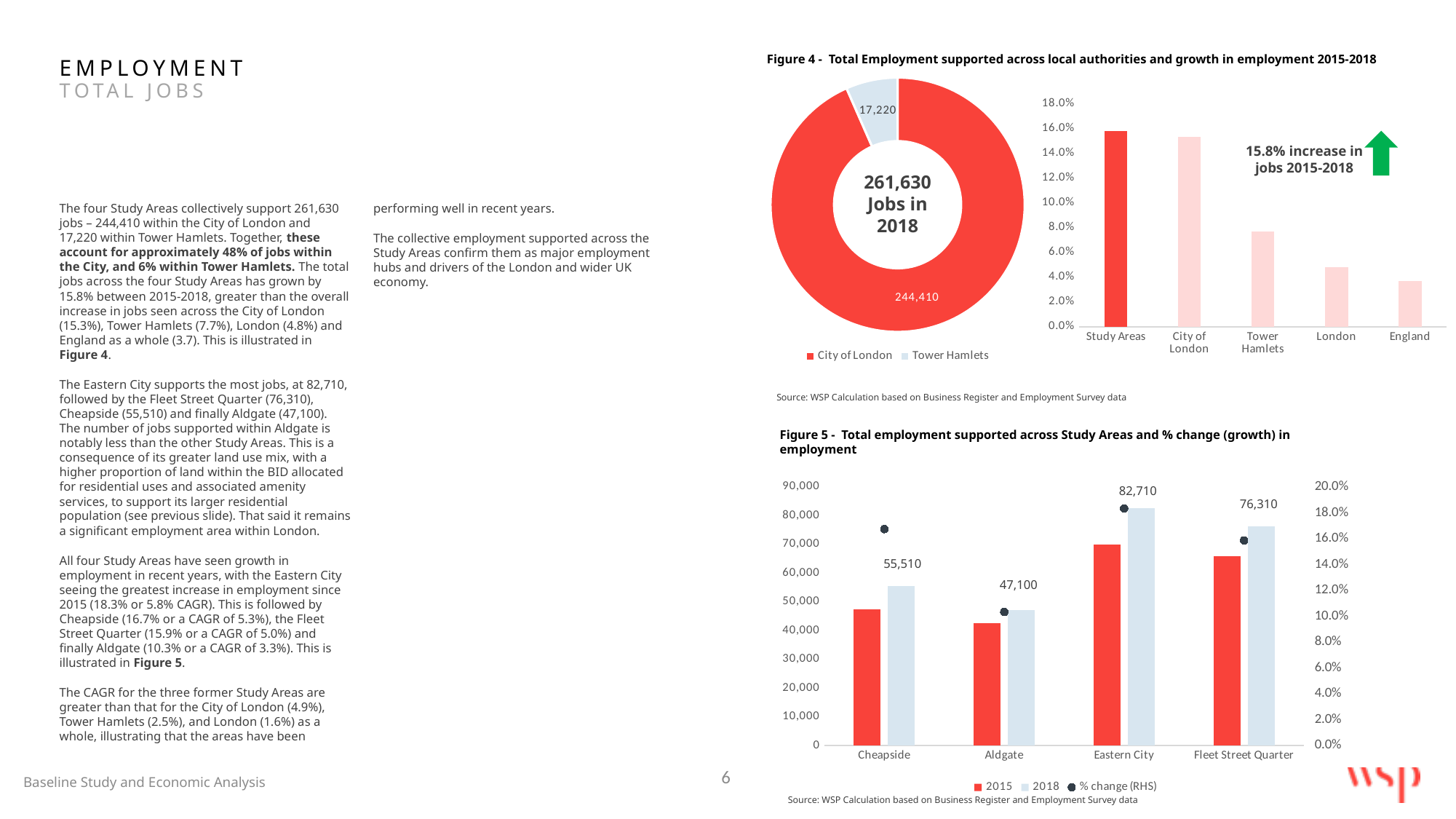
In the Figure 5 chart, what is the 2018 employment value for Eastern City? 82,710 In the Figure 4 bar chart of employment growth, is the value for London greater or less than 6.0%? less In the Figure 4 bar chart of employment growth, which category has the lowest value? England In the Figure 5 chart, what is the difference between the 2018 employment of Eastern City and Fleet Street Quarter? 6,400 In the Figure 5 chart, how many series does the legend list? 3 In the Figure 4 bar chart of employment growth, is the value for Tower Hamlets greater or less than 10.0%? less In the Figure 4 donut chart, what value is shown for Tower Hamlets? 17,220 In the Figure 4 donut chart, what value is shown for City of London? 244,410 In the Figure 4 bar chart of employment growth, how many local authority categories are shown on the x axis? 5 In the Figure 4 donut chart, what total number of jobs in 2018 is shown in the centre? 261,630 In the Figure 5 chart, is the 2015 employment value for Cheapside greater or less than 50,000? less In the Figure 5 chart, which Study Area has the lowest 2018 employment? Aldgate